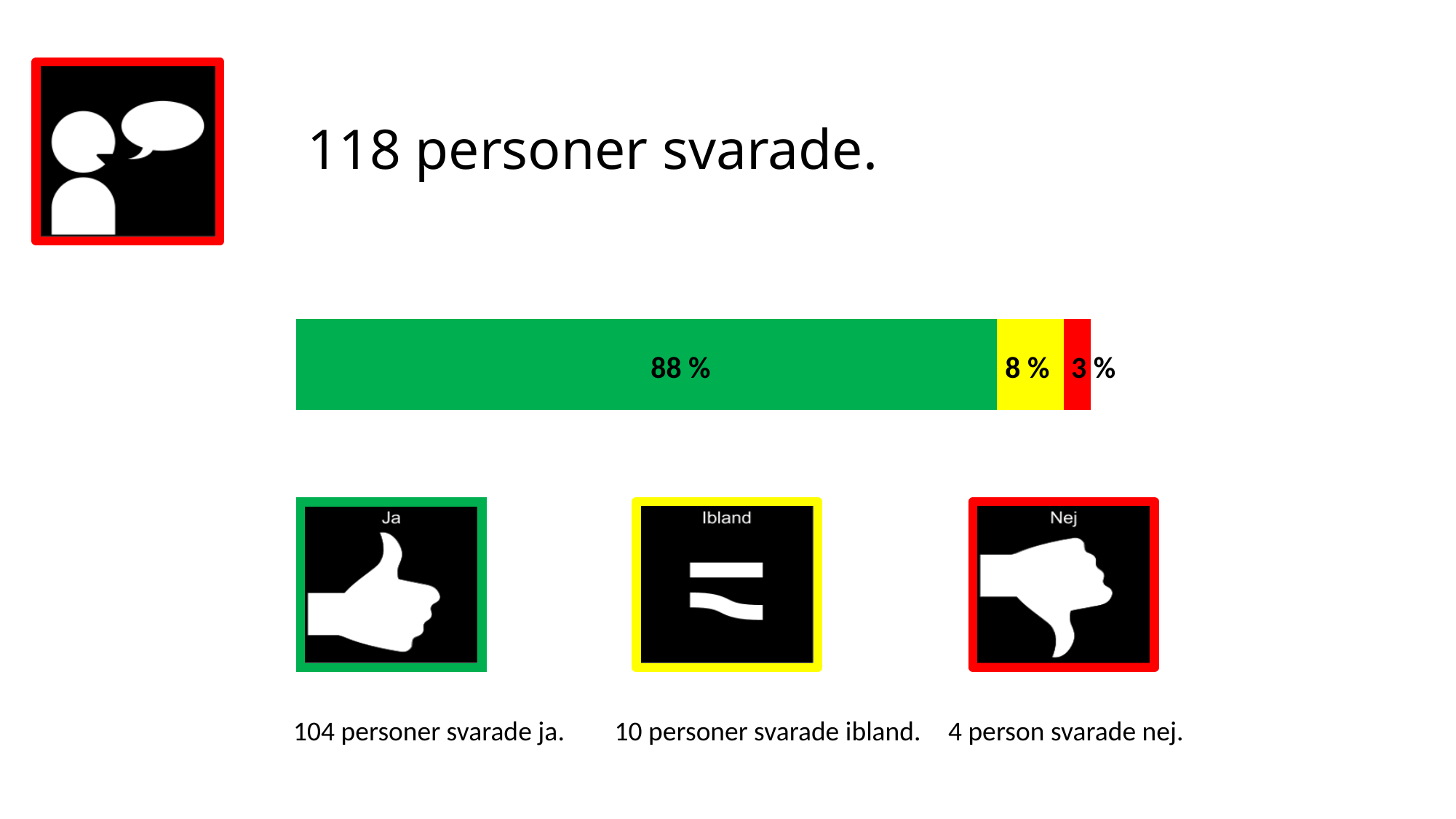
Which is larger, the yellow segment or the red segment? yellow segment What percentage is shown on the green segment of the bar? 88 % How many segments does the stacked bar have? 3 What percentage is shown on the red segment of the bar? 3 % What colour is the segment labelled 3 %? red Which segment of the bar has the largest value? the green segment (88 %) What is the difference between the yellow segment (8 %) and the red segment (3 %)? 5 % What colour is the segment labelled 88 %? green What is the difference between the green segment (88 %) and the yellow segment (8 %)? 80 % Which segment of the bar has the smallest value? the red segment (3 %) What percentage is shown on the yellow segment of the bar? 8 % What kind of chart is shown on the slide? bar chart